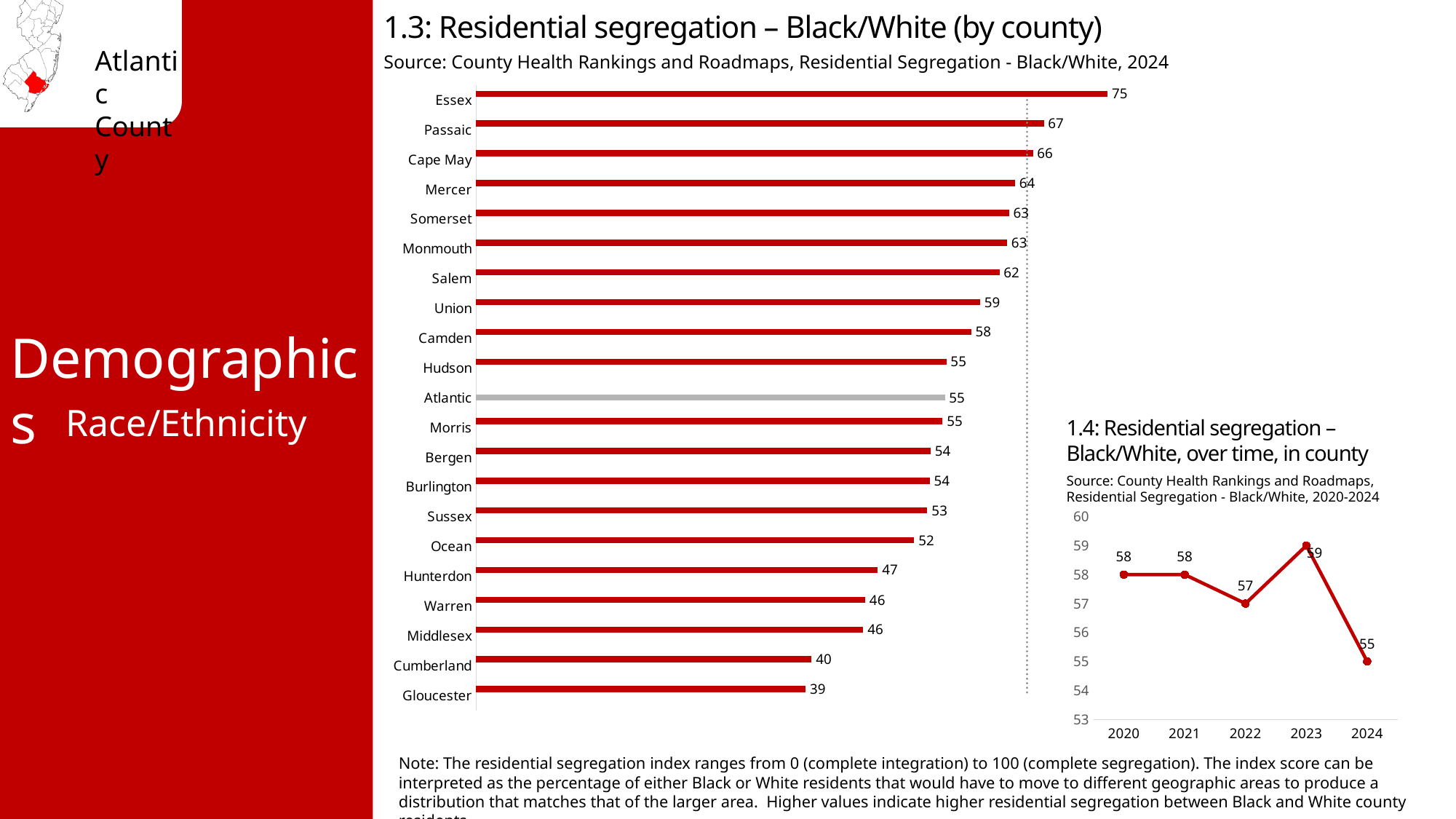
In chart 1.3 (by county), what is the value for Hunterdon? 47 In chart 1.3 (by county), which county has the lowest residential segregation index? Gloucester In chart 1.3 (by county), how many counties are shown? 21 In chart 1.3 (by county), which has a larger value, Passaic or Cumberland? Passaic In chart 1.3 (by county), what is the difference between the values for Essex and Gloucester? 36 What kind of chart is chart 1.3 (Residential segregation – Black/White by county)? Bar chart In chart 1.3 (Residential segregation – Black/White by county), what is the value for Atlantic? 55 In chart 1.4 (over time), which year has the lowest value? 2024 What kind of chart is chart 1.4 (Residential segregation – Black/White over time)? Line chart In chart 1.3 (by county), which county has the highest residential segregation index? Essex In chart 1.4 (over time), what is the difference between the values for 2023 and 2024? 4 In chart 1.4 (Residential segregation – Black/White over time), what is the value for 2023? 59